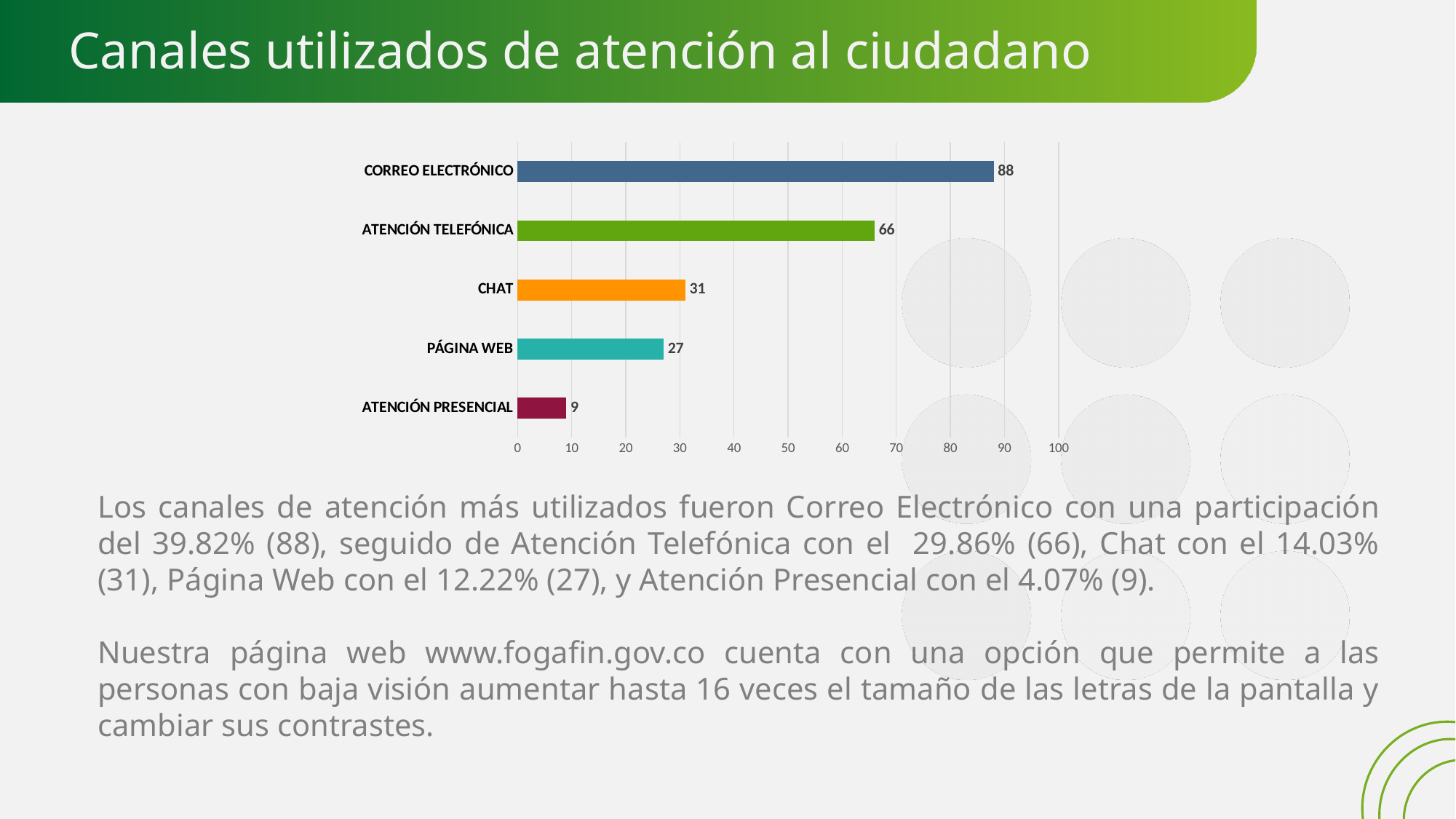
What is the value for ATENCIÓN PRESENCIAL? 9 What is the title of the slide containing the chart? Canales utilizados de atención al ciudadano What kind of chart is shown on the slide? Bar chart Which category has the highest value? CORREO ELECTRÓNICO What is the difference between the values for CORREO ELECTRÓNICO and ATENCIÓN TELEFÓNICA? 22 What is the value for CHAT? 31 Which is larger, the value for CHAT or the value for PÁGINA WEB? CHAT Which category has the lowest value? ATENCIÓN PRESENCIAL What is the value for ATENCIÓN TELEFÓNICA? 66 How many categories are shown in the chart? 5 What is the value for CORREO ELECTRÓNICO? 88 What is the value for PÁGINA WEB? 27